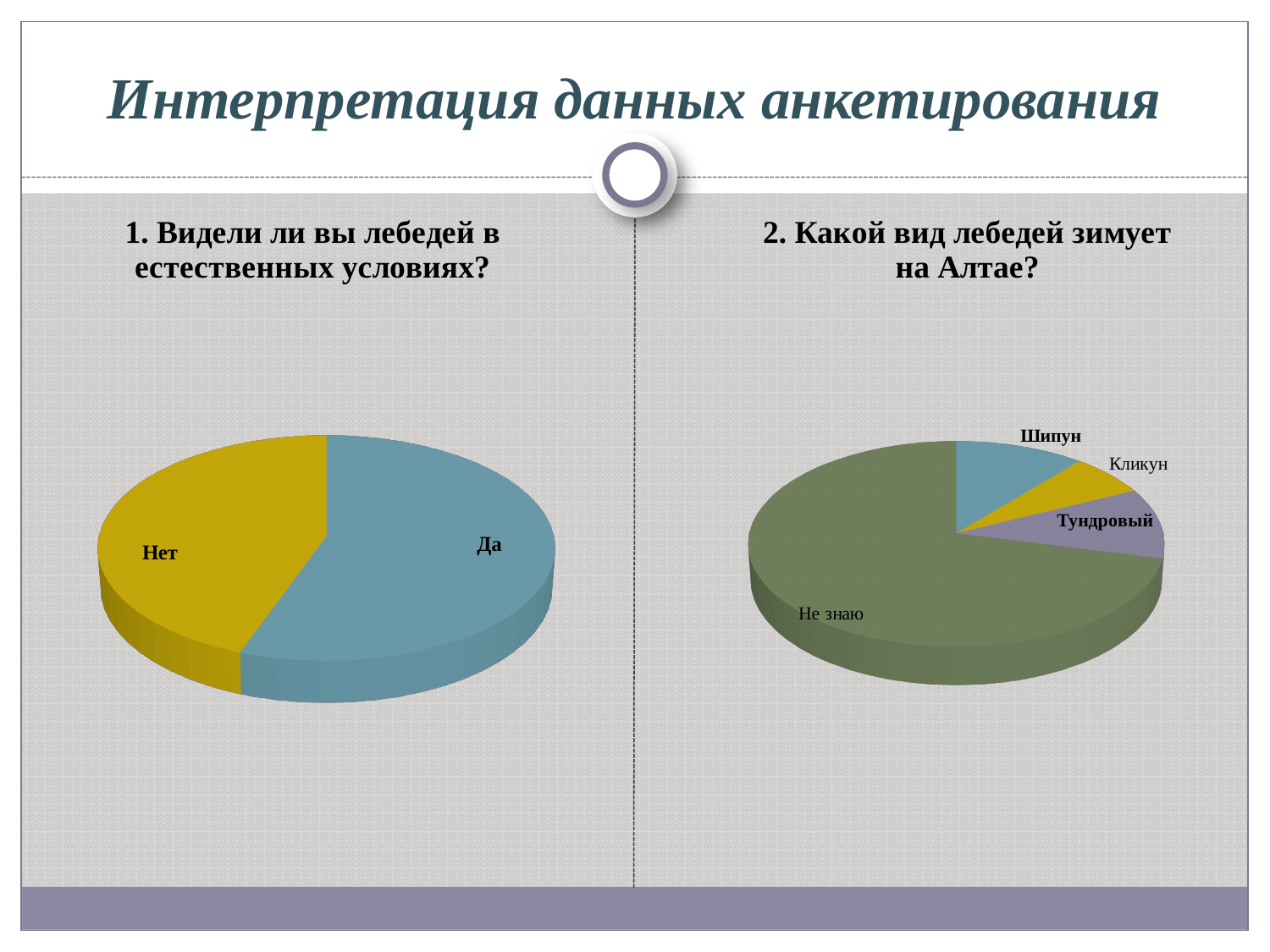
In the right chart (question 2), which answer has the largest slice? Не знаю In the right chart (question 2), what colour is the Не знаю slice? Green In the left chart (question 1), which answer has the smallest slice? Нет In the left chart (question 1), which answer has the largest slice? Да In the right chart (question 2), which slice is larger: Тундровый or Не знаю? Не знаю In the right chart (question 2), how many slices does the pie have? 4 In the right chart (question 2), which slice is larger: Не знаю or Шипун? Не знаю What kind of chart is used for question 1, "Видели ли вы лебедей в естественных условиях?"? Pie chart In the left chart (question 1), how many slices does the pie have? 2 What kind of chart is used for question 2, "Какой вид лебедей зимует на Алтае?"? Pie chart What is the title of the chart on the left side of the slide? 1. Видели ли вы лебедей в естественных условиях? In the left chart (question 1), which slice is larger: Да or Нет? Да